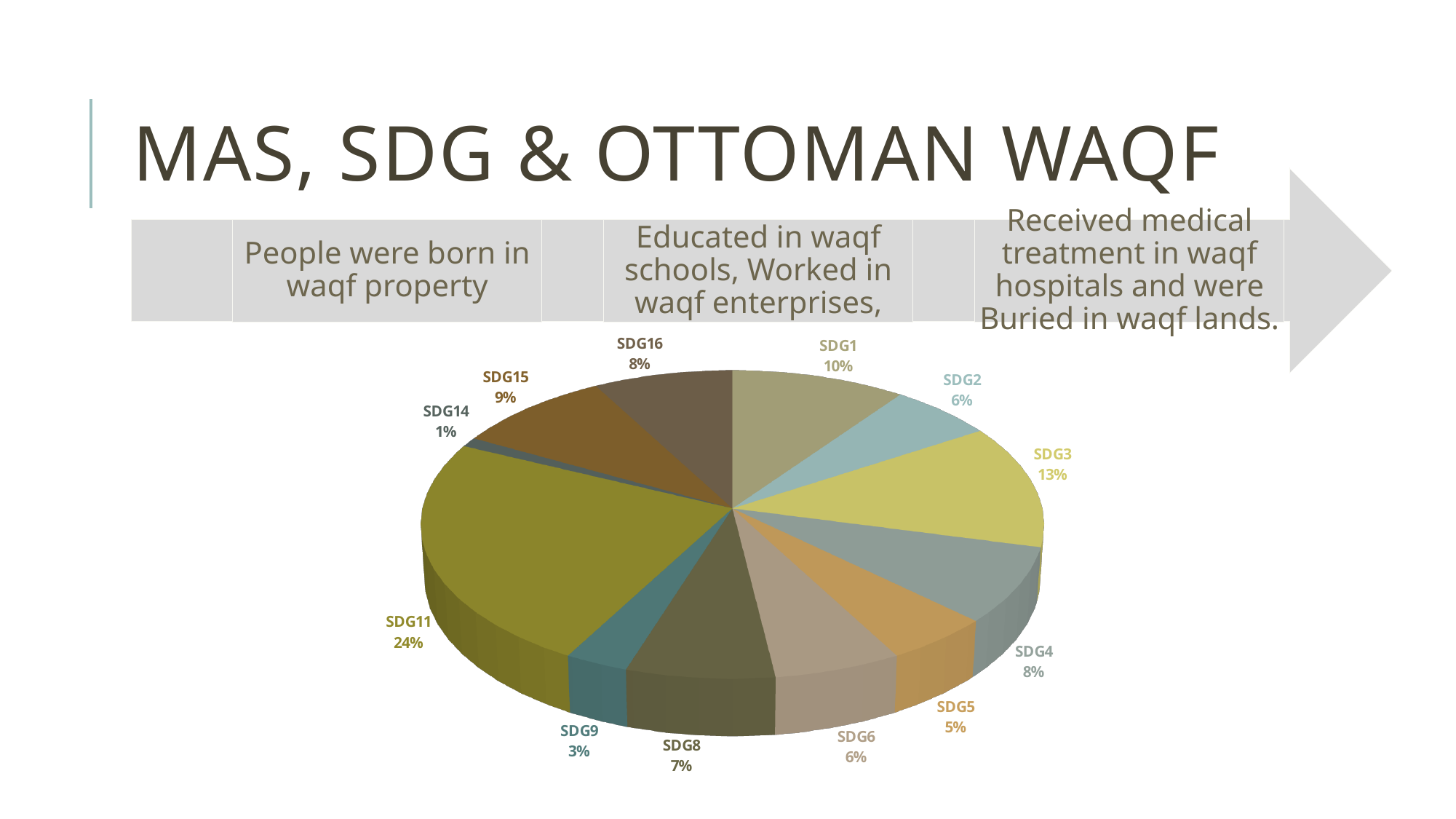
What kind of chart is shown on the slide? Pie chart Which slice is labelled 3%? SDG9 What percentage does the SDG15 slice represent? 9% What percentage does the SDG3 slice represent? 13% Which slice of the pie chart is the smallest? SDG14 Which slice of the pie chart is the largest? SDG11 What is the combined share of SDG2 and SDG6? 12% Which is larger, the SDG1 slice or the SDG16 slice? SDG1 What percentage does the SDG14 slice represent? 1% What percentage does the SDG11 slice represent? 24% How many slices does the pie chart have? 12 What is the difference in percentage points between SDG11 and SDG3? 11